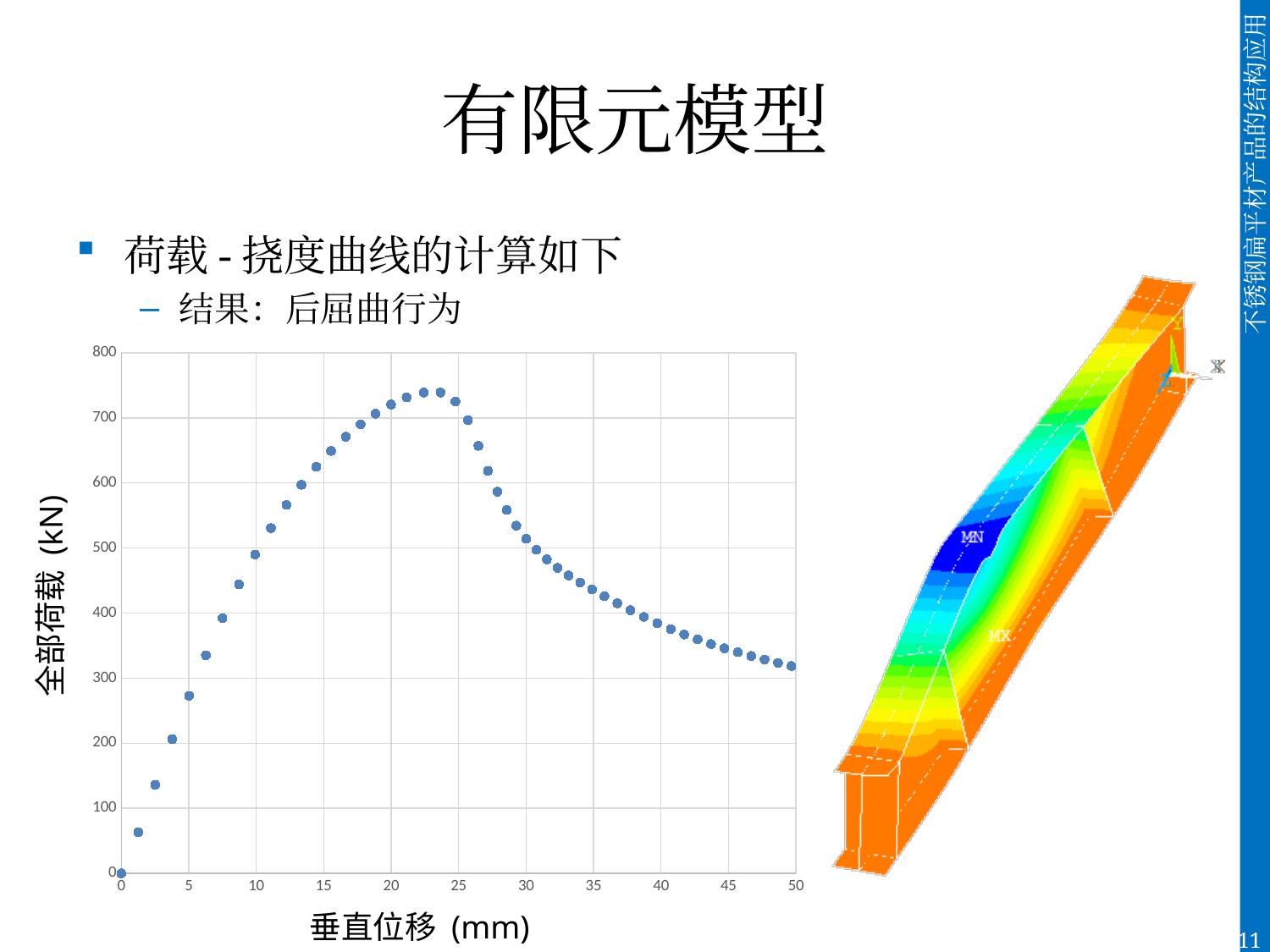
Is the peak value of the load curve greater or less than 700 kN? greater What is the label of the horizontal axis of the chart? 垂直位移 (mm) Does the load rise or fall as the vertical displacement increases from 0 mm to 20 mm? rise Is the load at a vertical displacement of 50 mm greater or less than 400 kN? less What kind of chart is shown on the slide? scatter chart What is the maximum value shown on the vertical axis of the chart? 800 Is the load at a vertical displacement of 10 mm greater or less than 400 kN? greater What is the label of the vertical axis of the chart? 全部荷载 (kN) Which is larger, the load at 20 mm displacement or the load at 40 mm displacement? 20 mm Does the load rise or fall as the vertical displacement increases from 25 mm to 50 mm? fall